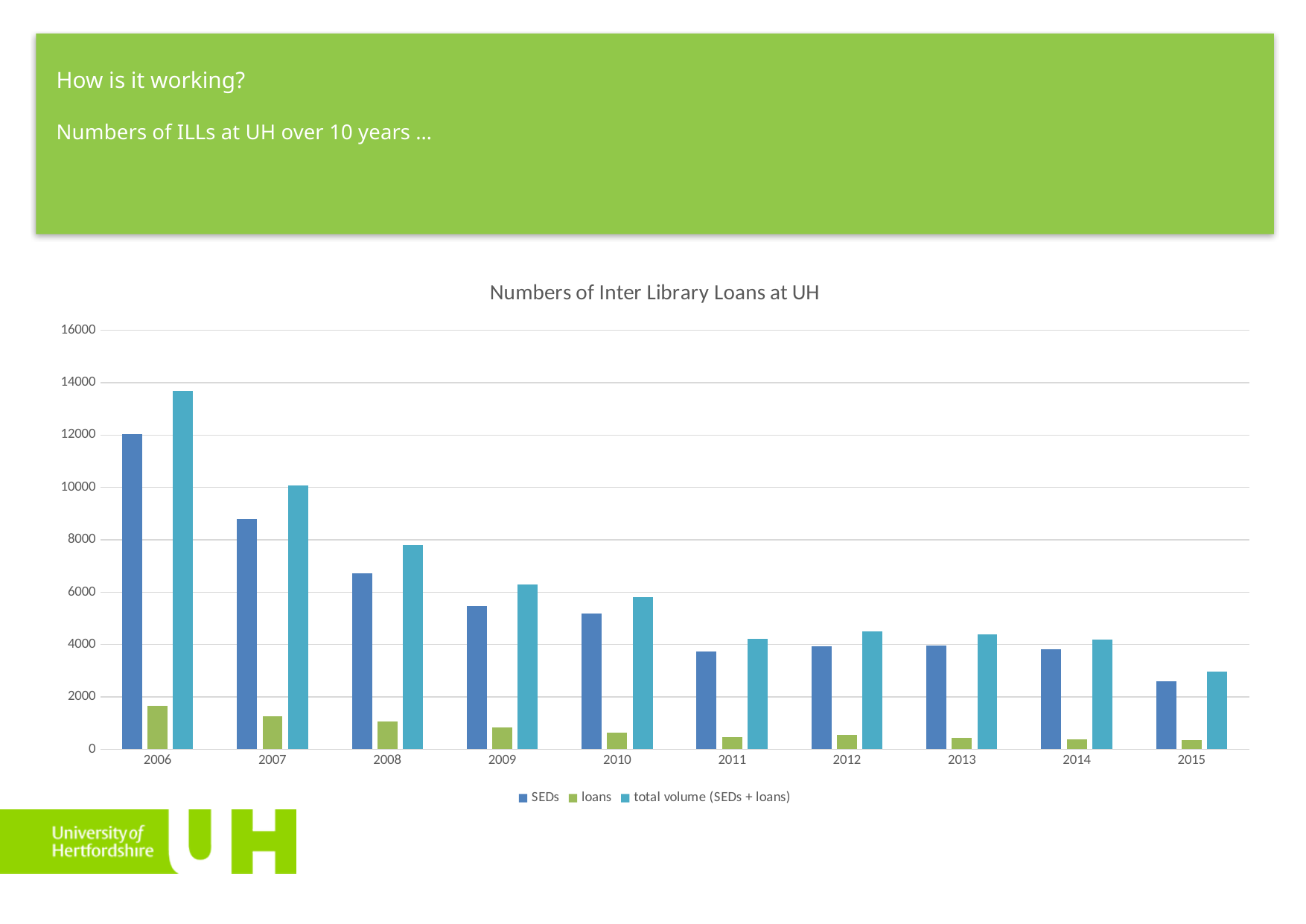
Is the SEDs value for 2006 greater or less than 10000? greater Is the loans value for 2006 greater or less than 2000? less What is the title of the chart? Numbers of Inter Library Loans at UH How many years are shown on the x axis? 10 Do the total volume (SEDs + loans) values generally rise or fall from 2006 to 2015? fall What kind of chart is shown on the slide? bar chart Which year has the lowest total volume (SEDs + loans)? 2015 How many series does the legend list? 3 Which year has the highest SEDs value? 2006 Which year has the highest total volume (SEDs + loans)? 2006 Which is larger, the SEDs value for 2007 or the SEDs value for 2008? 2007 Is the total volume (SEDs + loans) for 2015 greater or less than 4000? less